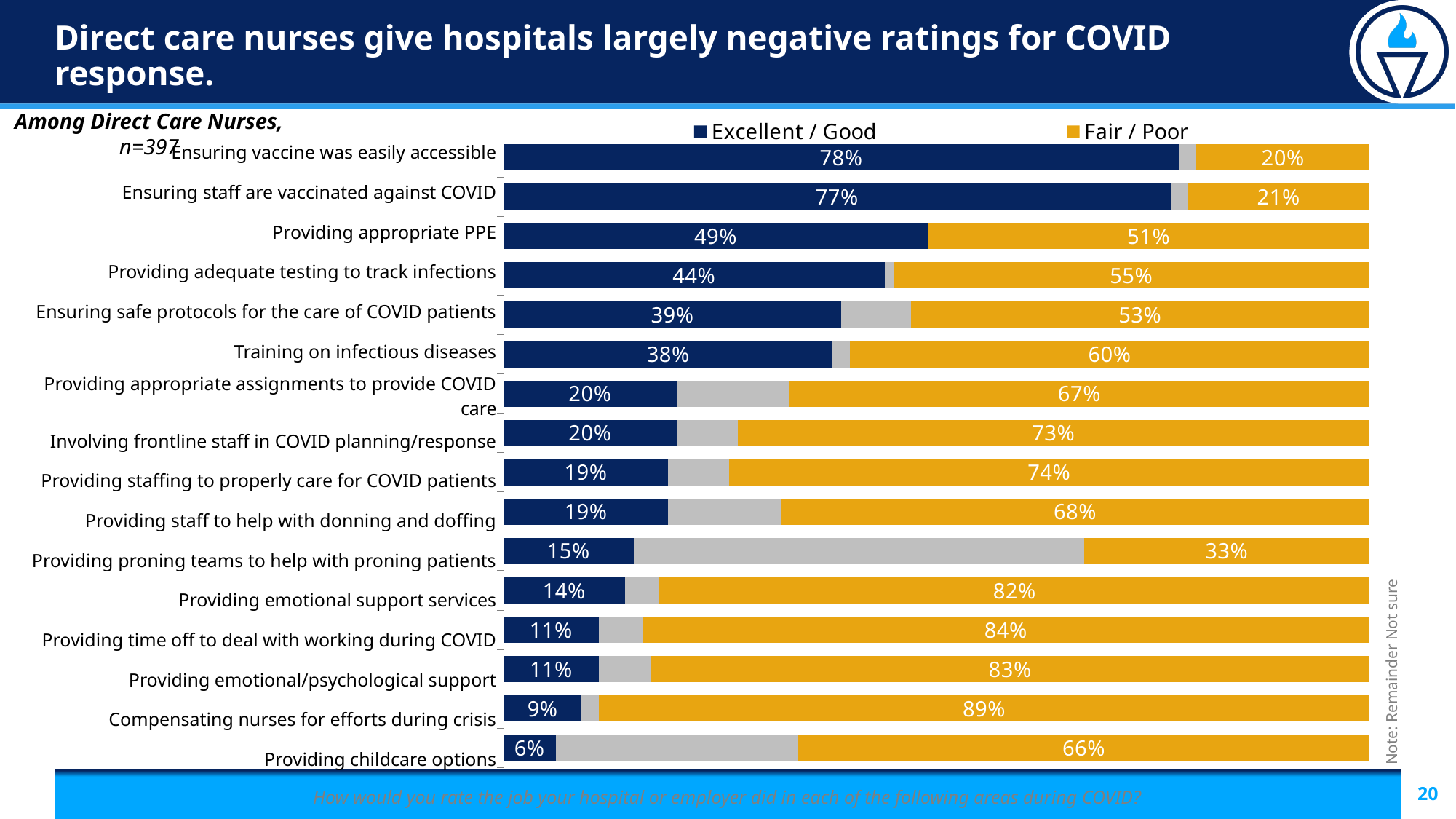
Which area has the highest Excellent / Good rating? Ensuring vaccine was easily accessible What type of chart is shown on the slide? Stacked bar chart What is the Fair / Poor value for 'Compensating nurses for efforts during crisis'? 89% What is the Fair / Poor value for 'Providing proning teams to help with proning patients'? 33% What percentage of direct care nurses rated 'Ensuring vaccine was easily accessible' as Excellent / Good? 78% Which has a higher Fair / Poor rating: 'Providing time off to deal with working during COVID' or 'Providing emotional support services'? Providing time off to deal with working during COVID Which area has the highest Fair / Poor rating? Compensating nurses for efforts during crisis What is the Excellent / Good value for 'Providing appropriate PPE'? 49% What is the difference in percentage points between the Excellent / Good ratings for 'Ensuring vaccine was easily accessible' and 'Providing childcare options'? 72 percentage points How many series does the chart legend list? 2 Which area has the lowest Excellent / Good rating? Providing childcare options How many areas (categories) are rated in the chart? 16